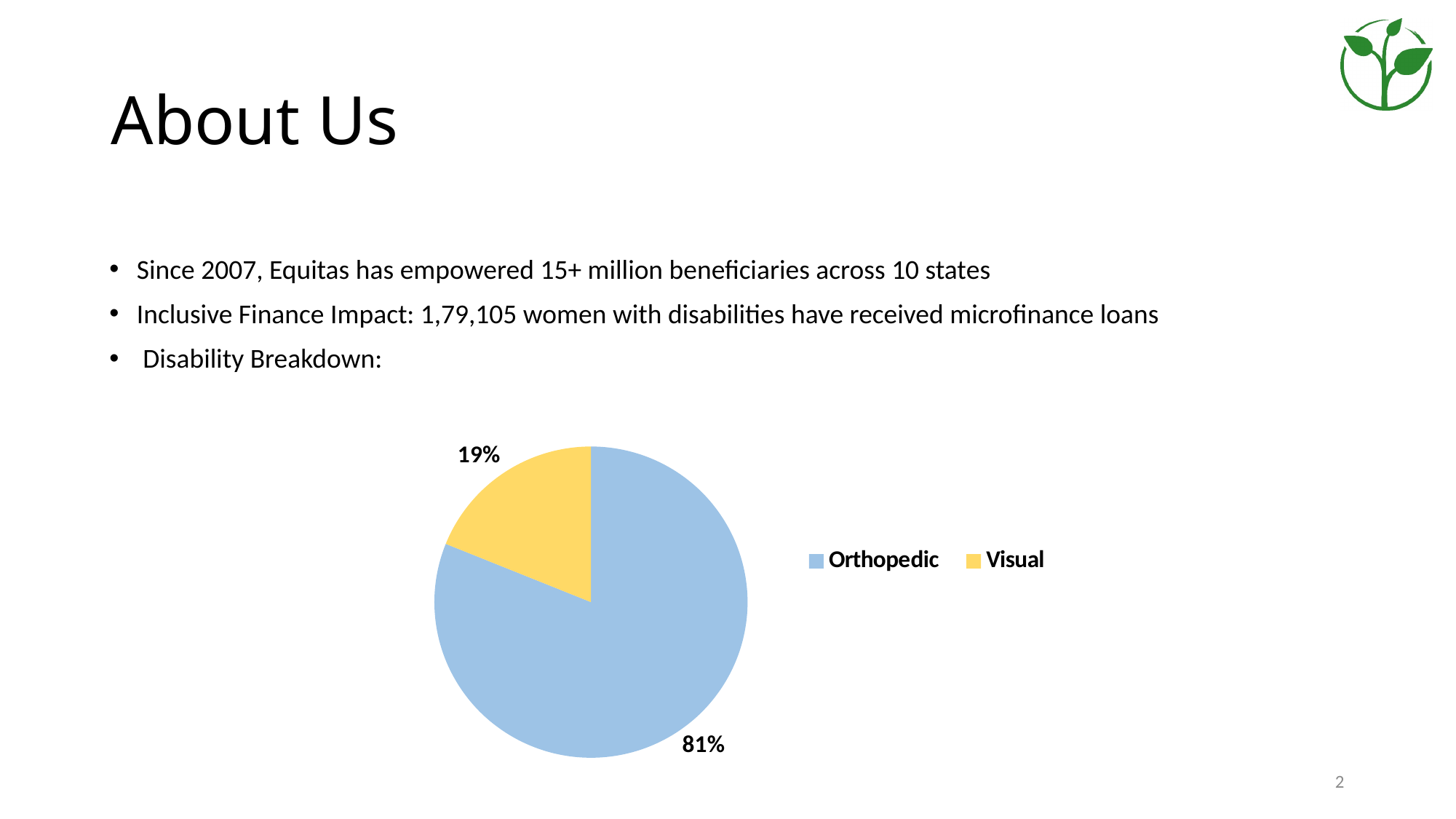
What share of the pie does Visual represent? 19% Which category has the smallest slice of the pie? Visual How many entries does the legend list? 2 What colour is the Visual slice of the pie? yellow How many categories does the pie chart show? 2 What is the difference in percentage points between the Orthopedic and Visual slices? 62 What colour is the Orthopedic slice of the pie? blue What share of the pie does Orthopedic represent? 81% Which is larger, the Orthopedic slice or the Visual slice? Orthopedic What kind of chart is shown on the slide? pie chart Which category has the largest slice of the pie? Orthopedic